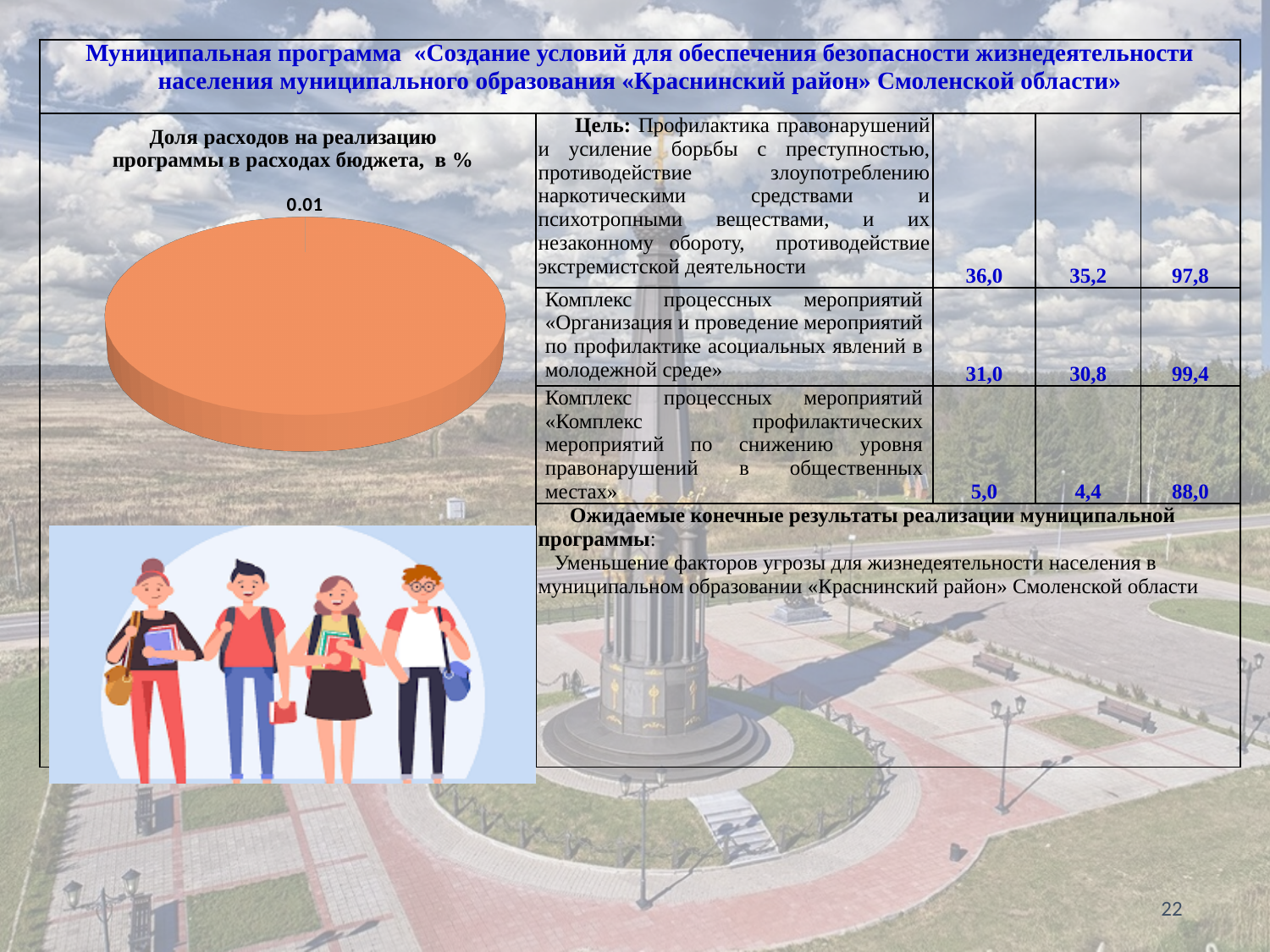
What colour is the slice of the pie chart? orange What kind of chart is shown on the slide? pie chart What is the title of the chart on the slide? Доля расходов на реализацию программы в расходах бюджета, в % Is the value labelled on the pie chart greater or less than 1? less What value is printed as the data label on the pie chart? 0.01